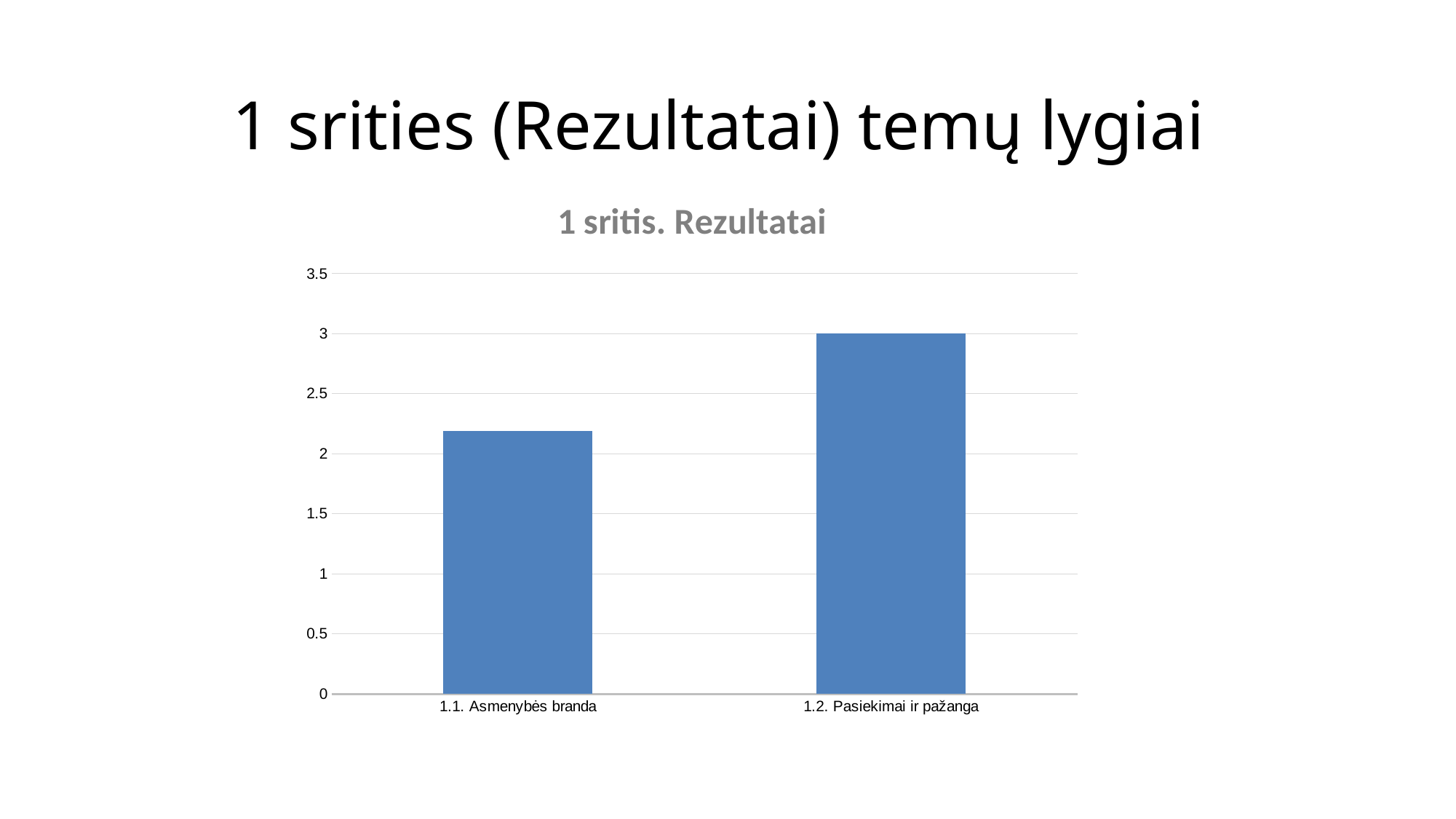
Which category has the lowest value? 1.1. Asmenybės branda Is the value for 1.1. Asmenybės branda greater or less than 2? greater Which category has the highest value? 1.2. Pasiekimai ir pažanga Is the value for 1.1. Asmenybės branda greater or less than 2.5? less What is the value for 1.2. Pasiekimai ir pažanga? 3 Is the value for 1.2. Pasiekimai ir pažanga greater or less than 3.5? less What kind of chart is shown on the slide? bar chart Which is larger, the value for 1.1. Asmenybės branda or the value for 1.2. Pasiekimai ir pažanga? 1.2. Pasiekimai ir pažanga What colour are the bars in the chart? blue How many categories are plotted in the chart? 2 What is the title of the chart? 1 sritis. Rezultatai Do the values rise or fall from left to right along the x axis? rise